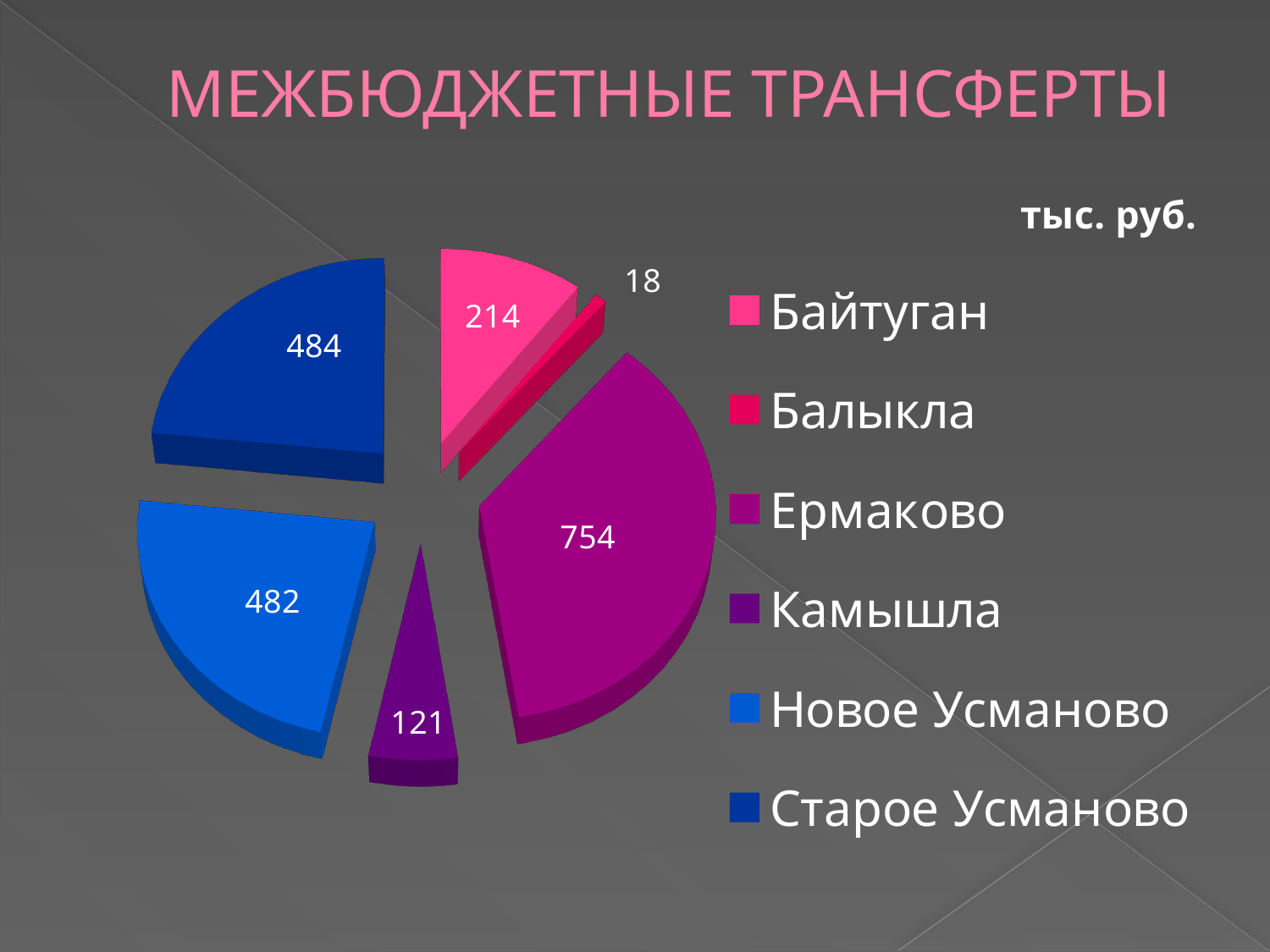
What type of chart is shown on the slide? pie chart What is the total of all the values shown in the pie chart? 2073 What is the difference between the values for Ермаково and Байтуган? 540 How many categories does the pie chart have? 6 What is the value for Камышла? 121 Which is larger, the value for Старое Усманово or the value for Новое Усманово? Старое Усманово What unit is indicated for the values in the chart? тыс. руб. What is the value for Балыкла? 18 What is the value for Ермаково? 754 What is the value for Байтуган? 214 Which category has the smallest slice of the pie? Балыкла Which category has the largest slice of the pie? Ермаково